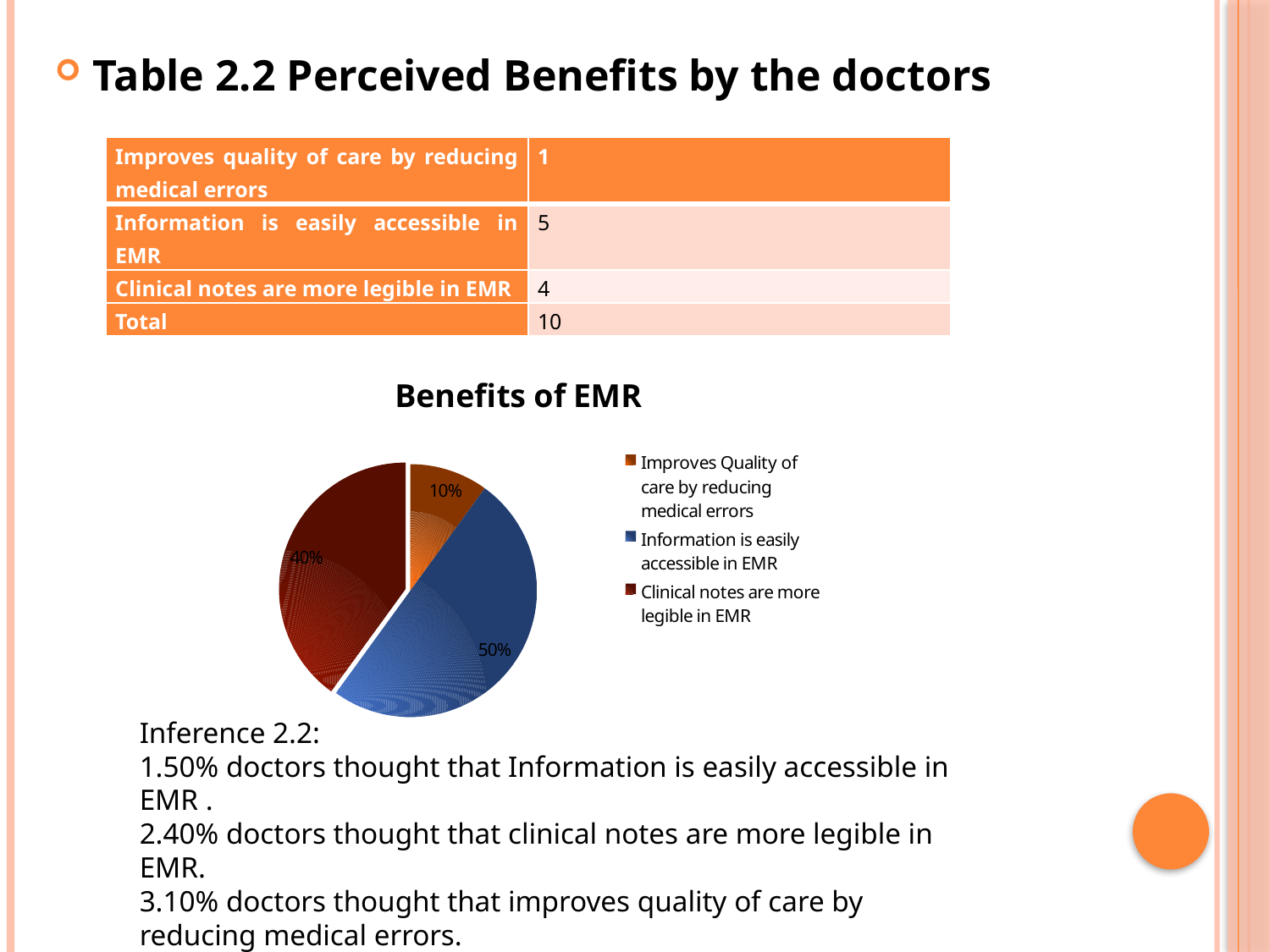
What share of the pie is 'Improves Quality of care by reducing medical errors'? 10% Which legend entry is shown in blue? Information is easily accessible in EMR What kind of chart is shown on the slide? pie chart What is the title of the chart? Benefits of EMR What is the difference in percentage points between the 'Information is easily accessible in EMR' slice and the 'Clinical notes are more legible in EMR' slice? 10% Which category has the largest slice of the pie? Information is easily accessible in EMR What share of the pie is 'Information is easily accessible in EMR'? 50% Which category has the smallest slice of the pie? Improves Quality of care by reducing medical errors Which slice is larger: 'Clinical notes are more legible in EMR' or 'Improves Quality of care by reducing medical errors'? Clinical notes are more legible in EMR How many slices does the pie chart have? 3 What share of the pie is 'Clinical notes are more legible in EMR'? 40% How many entries does the legend list? 3